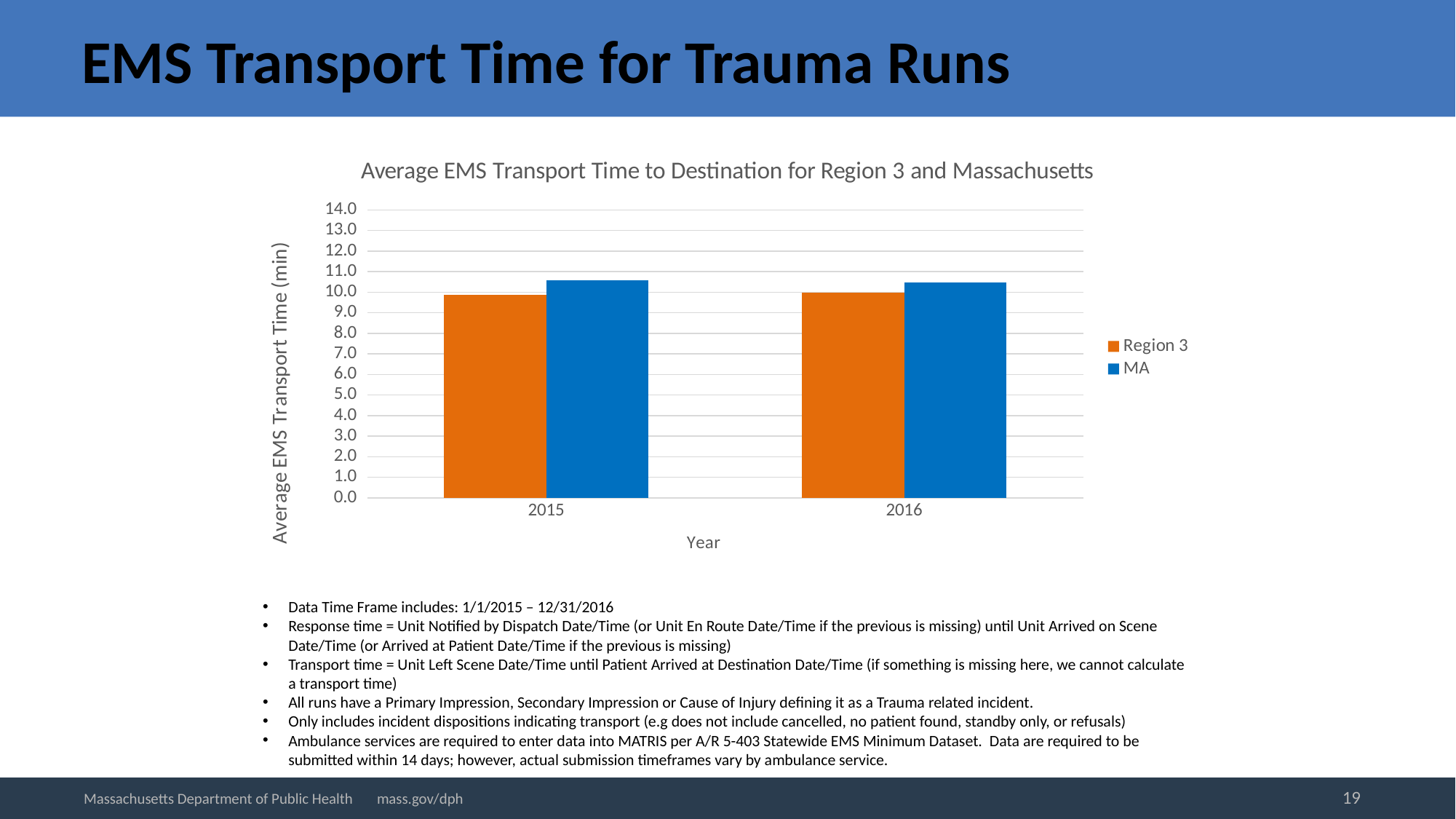
What is the title of the chart? Average EMS Transport Time to Destination for Region 3 and Massachusetts In 2016, which is larger: the average transport time for Region 3 or for MA? MA Is the value for Region 3 in 2016 greater or less than 11.0? less Is the value for MA in 2016 less or greater than 11.0? less What kind of chart is shown on the slide? bar chart Which series is shown in orange in the chart? Region 3 How many series does the chart's legend list? 2 Is the value for MA in 2015 greater or less than 10.0? greater How many years are shown on the x axis of the chart? 2 In 2015, which is larger: the average transport time for Region 3 or for MA? MA